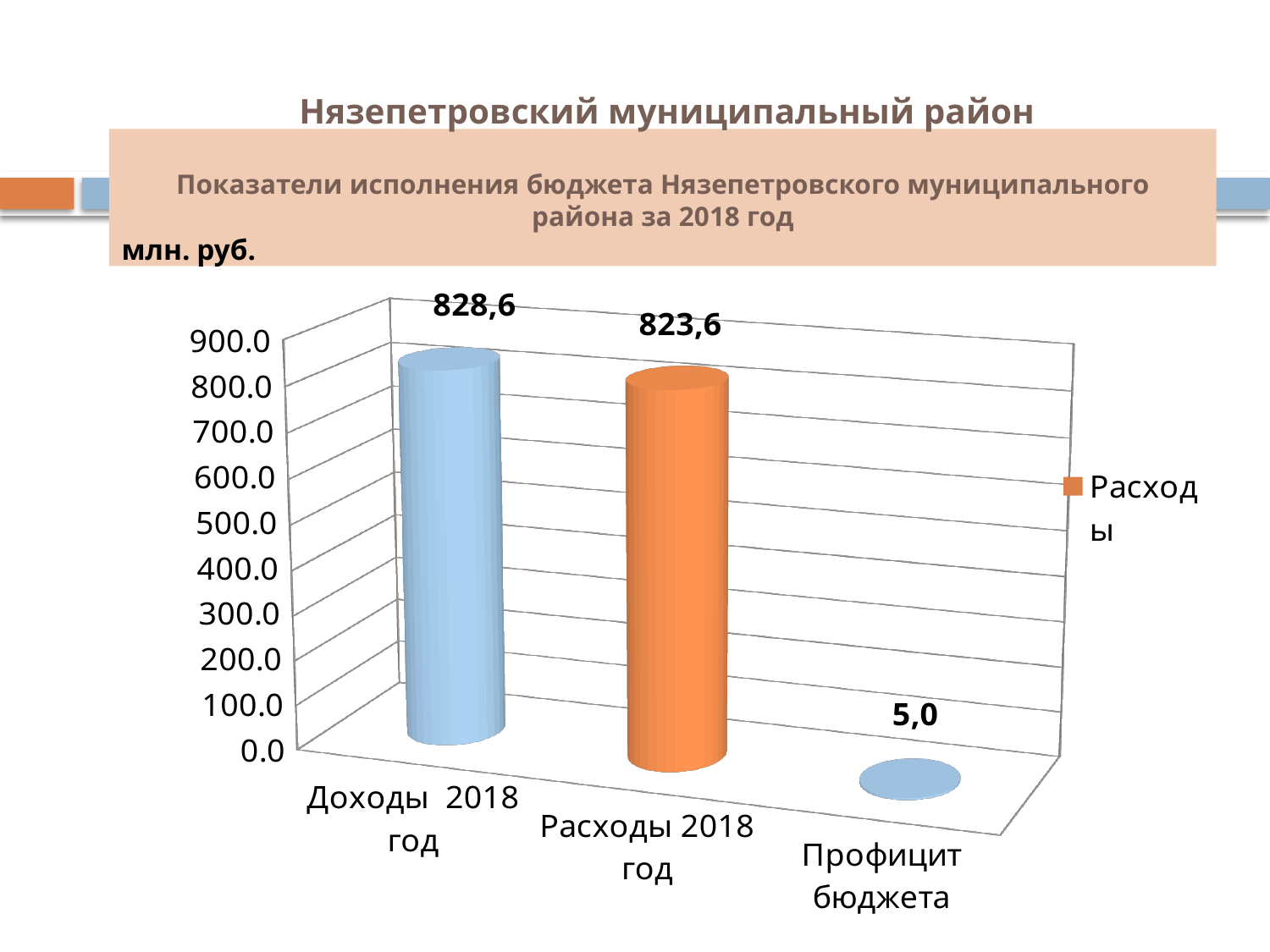
How many series does the legend list? 1 How many categories are shown on the x axis? 3 What is the value for Расходы 2018 год? 823,6 What kind of chart is shown on the slide? bar chart Which is larger, Доходы 2018 год or Расходы 2018 год? Доходы 2018 год What is the value for Доходы 2018 год? 828,6 Which category has the lowest value? Профицит бюджета Is the value for Профицит бюджета greater or less than 100.0? less What is the value for Профицит бюджета? 5,0 What is the difference between Доходы 2018 год and Расходы 2018 год? 5,0 Which category has the highest value? Доходы 2018 год What unit of measurement is stated for the chart values? млн. руб.